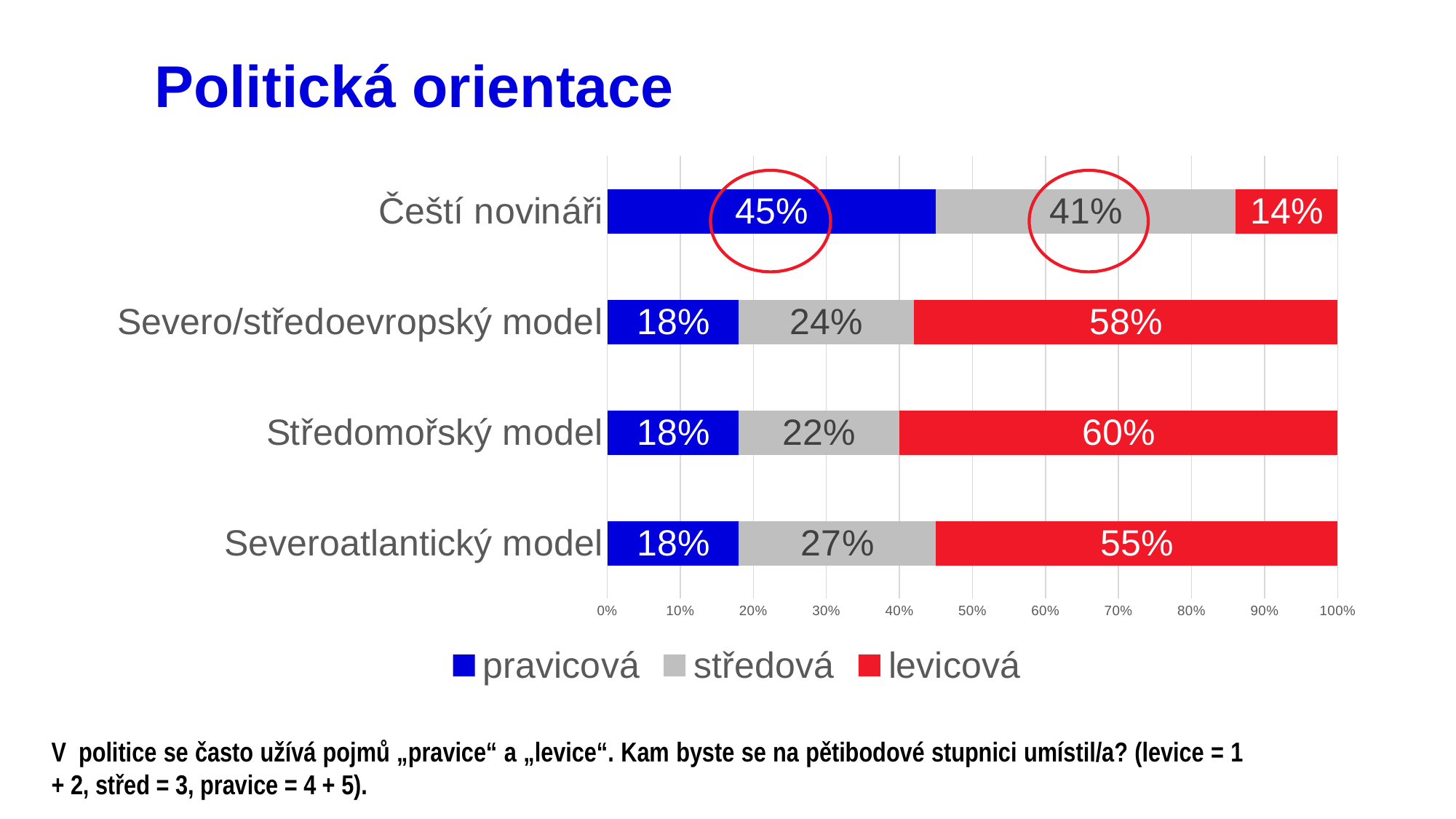
What kind of chart is shown on the slide? Stacked bar chart What is the value for pravicová for Čeští novináři? 45% How many series does the legend list? 3 Which category has the highest levicová value? Středomořský model What is the value for levicová for Středomořský model? 60% What is the value for středová for Severoatlantický model? 27% What is the value for středová for Severo/středoevropský model? 24% What is the difference between the pravicová value for Čeští novináři and the pravicová value for Severoatlantický model? 27% Which colour represents the levicová series? Red Which category has the lowest levicová value? Čeští novináři Which is larger: the středová value for Čeští novináři or the středová value for Středomořský model? Čeští novináři How many categories are shown on the chart? 4